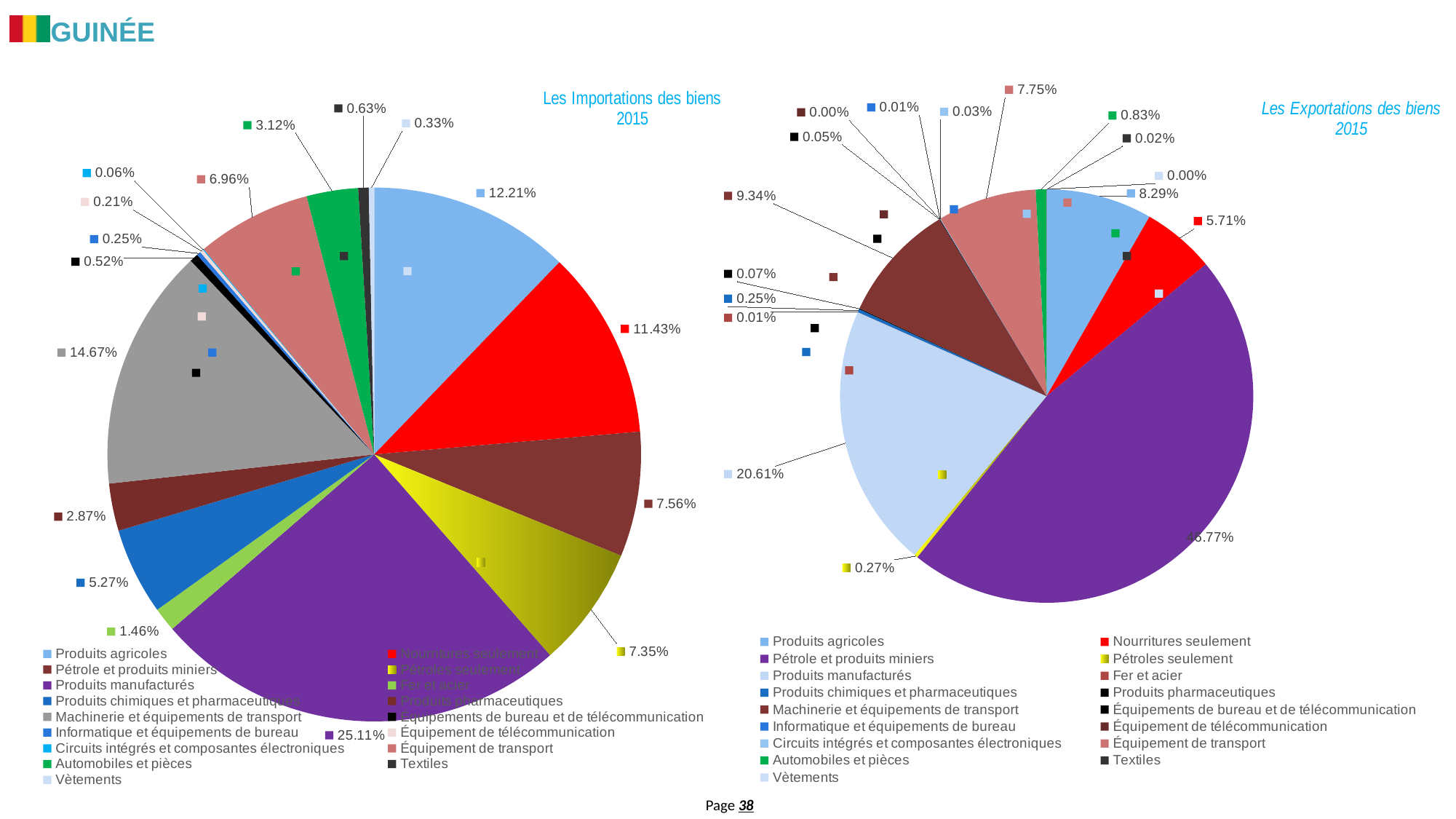
What kind of charts are shown on the slide? Pie charts In the 'Les Importations des biens 2015' chart, which category has the largest share? Produits manufacturés In the 'Les Exportations des biens 2015' chart, which is larger: Produits agricoles or Nourritures seulement? Produits agricoles In the 'Les Exportations des biens 2015' chart, which category has the largest share? Pétrole et produits miniers In the 'Les Importations des biens 2015' chart, which category has the smallest share? Circuits intégrés et composantes électroniques In the 'Les Importations des biens 2015' chart, what is the difference between the shares of Produits agricoles and Nourritures seulement? 0.78% In the 'Les Exportations des biens 2015' chart, what is the share for Produits manufacturés? 20.61% How many categories does the legend of the 'Les Exportations des biens 2015' chart list? 17 In the 'Les Importations des biens 2015' chart, which is larger: Équipement de transport or Automobiles et pièces? Équipement de transport In the 'Les Importations des biens 2015' chart, what is the share for Produits manufacturés? 25.11% In the 'Les Importations des biens 2015' chart, what is the share for Machinerie et équipements de transport? 14.67% In the 'Les Exportations des biens 2015' chart, what is the share for Machinerie et équipements de transport? 9.34%